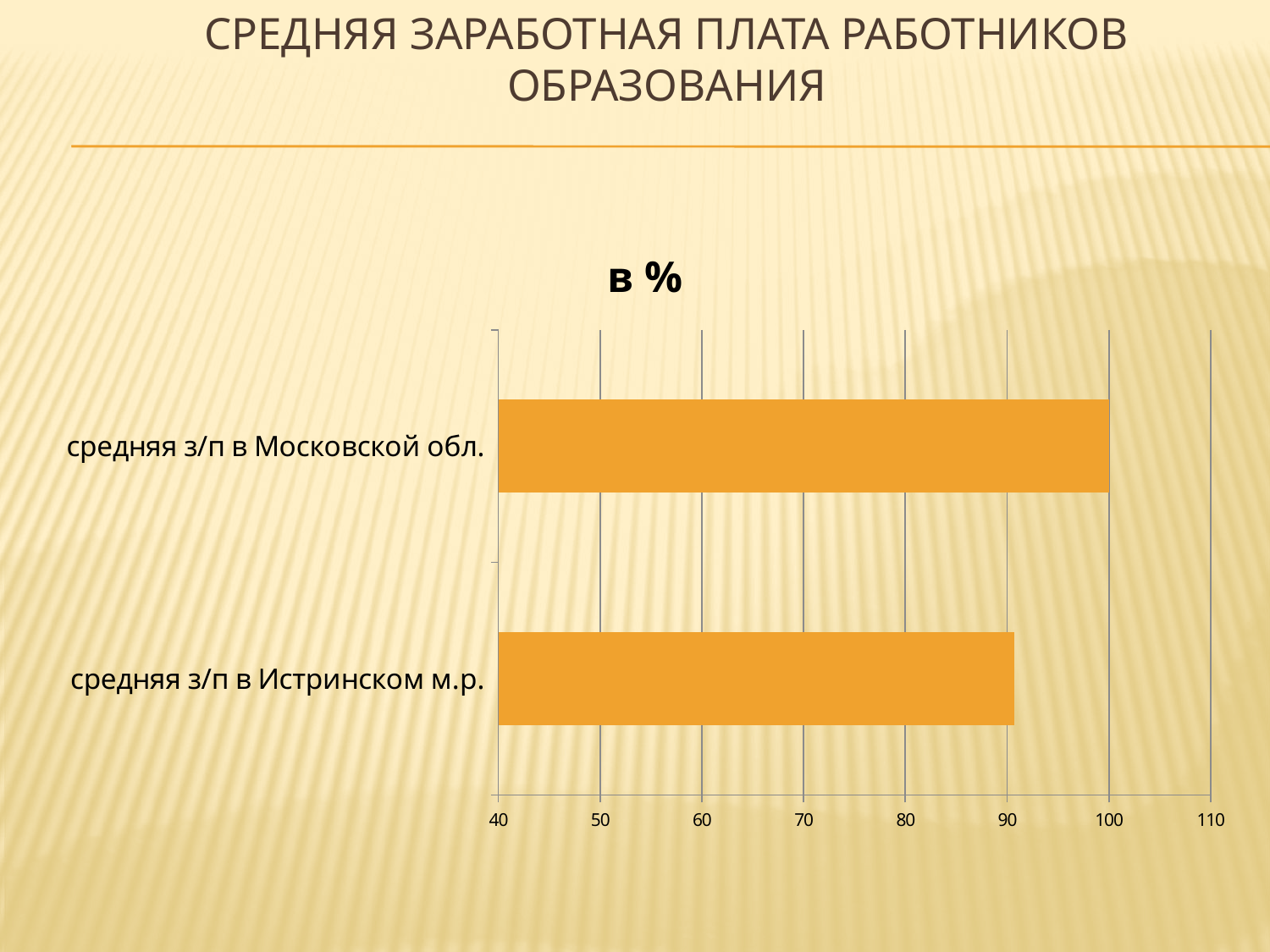
What kind of chart is shown on the slide? bar chart What is the value for средняя з/п в Московской обл.? 100 Is the value for средняя з/п в Истринском м.р. greater or less than 80? greater Which category has the highest value? средняя з/п в Московской обл. What is the lowest value shown on the horizontal axis? 40 Which category has the lowest value? средняя з/п в Истринском м.р. How many categories does the chart show? 2 Is the value for средняя з/п в Истринском м.р. greater or less than 100? less Which is larger: the value for средняя з/п в Московской обл. or the value for средняя з/п в Истринском м.р.? средняя з/п в Московской обл. What is the title of the chart? в %